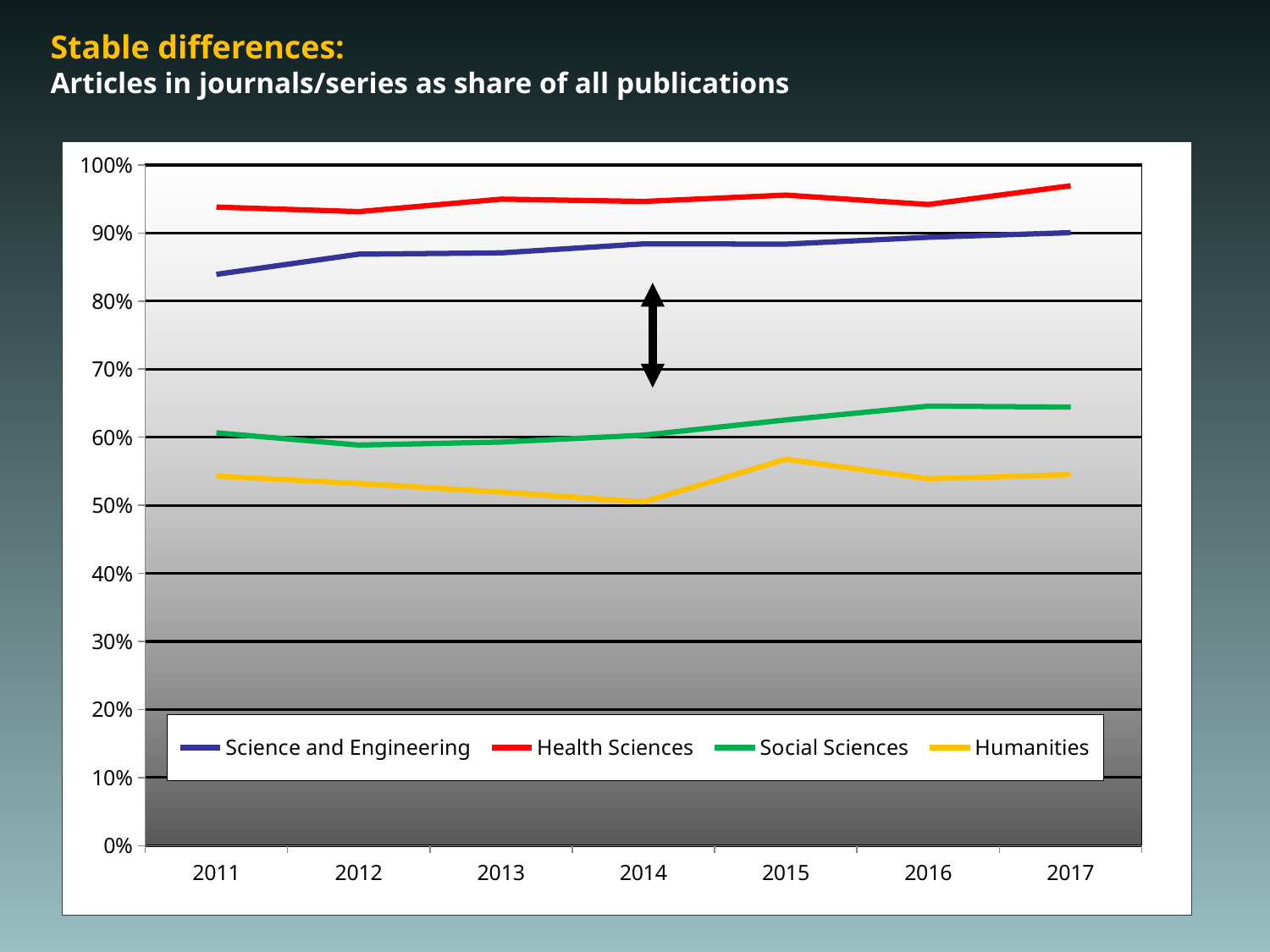
How many years are shown on the x axis? 7 Does the Science and Engineering line rise or fall from 2011 to 2017? rise What kind of chart is shown on the slide? line chart Is the value for Science and Engineering in 2011 greater or less than 80%? greater Which series has the highest share in 2017? Health Sciences In 2015, which is larger: the share for Social Sciences or for Humanities? Social Sciences Is the value for Humanities in 2014 greater or less than 60%? less Is the value for Social Sciences in 2016 greater or less than 60%? greater How many series does the legend list? 4 Which series has the lowest share in 2011? Humanities What colour is the Health Sciences line in the legend? red